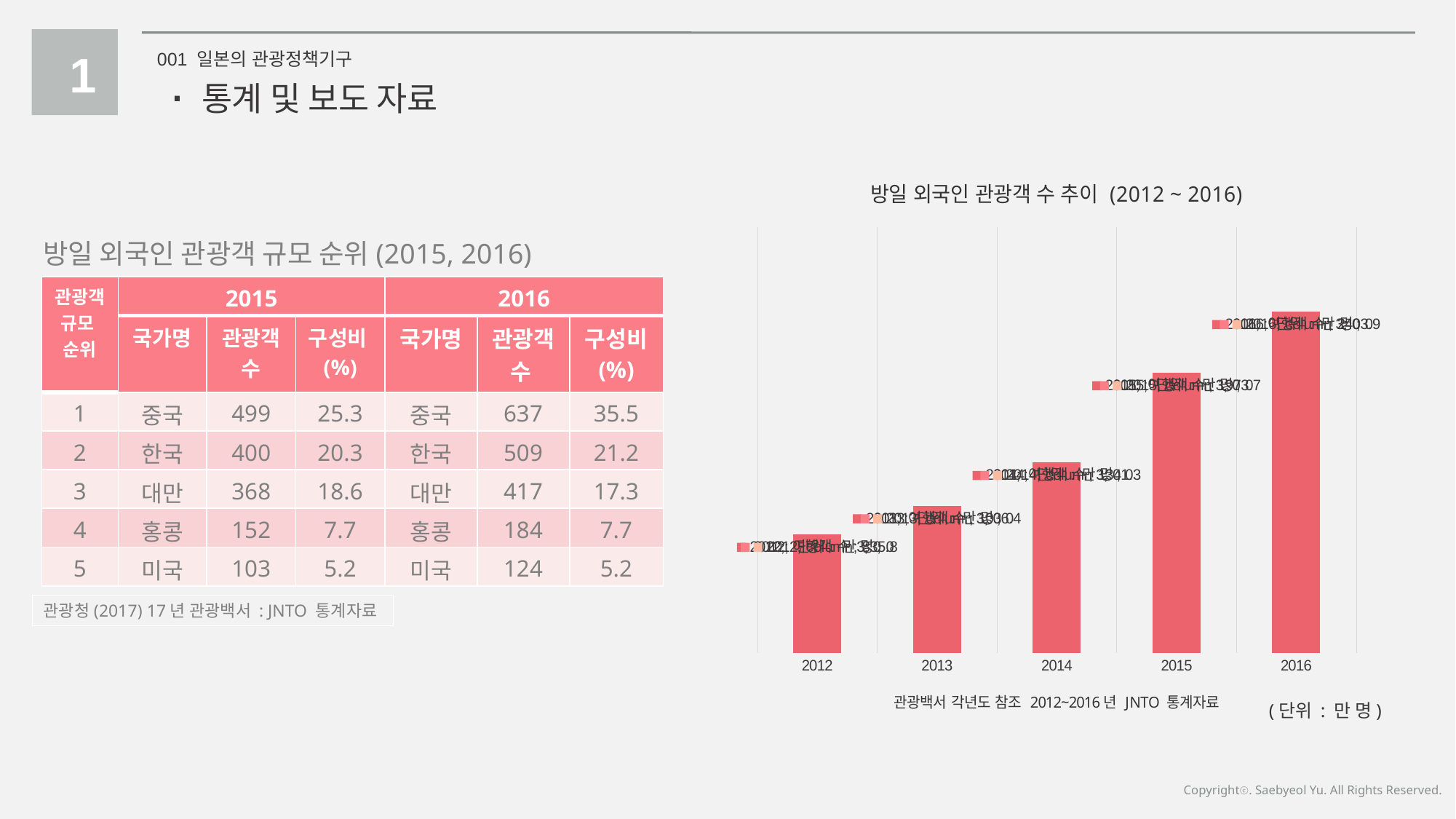
What kind of chart is shown on the right side of the slide? bar chart In the chart 방일 외국인 관광객 수 추이 (2012 ~ 2016), which bar is taller, 2014 or 2015? 2015 In the chart 방일 외국인 관광객 수 추이 (2012 ~ 2016), which bar is taller, 2012 or 2013? 2013 How many years (bars) are plotted in the chart titled 방일 외국인 관광객 수 추이 (2012 ~ 2016)? 5 In the chart 방일 외국인 관광객 수 추이 (2012 ~ 2016), which bar is taller, 2013 or 2016? 2016 In the chart 방일 외국인 관광객 수 추이 (2012 ~ 2016), which year has the lowest bar? 2012 In the chart 방일 외국인 관광객 수 추이 (2012 ~ 2016), do the values rise or fall from 2012 to 2016? rise What unit is stated for the values in the bar chart on the slide? 만 명 In the chart 방일 외국인 관광객 수 추이 (2012 ~ 2016), which year has the highest bar? 2016 What is the title of the bar chart on the slide? 방일 외국인 관광객 수 추이 (2012 ~ 2016)